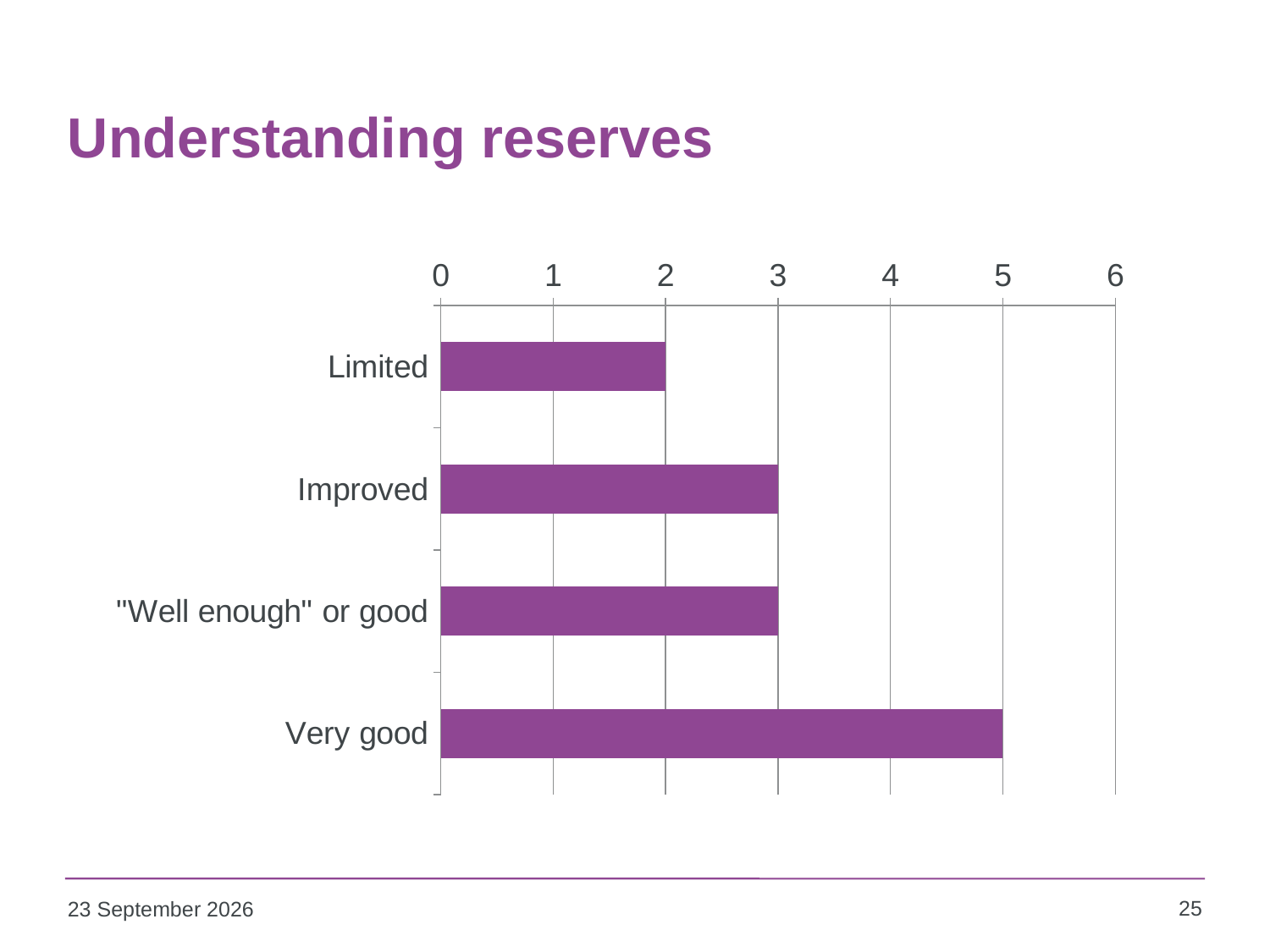
What is the title of the slide containing the chart? Understanding reserves What is the value for Limited? 2 What is the value for "Well enough" or good? 3 Is the value for Very good greater or less than 4? greater What is the value for Very good? 5 What is the difference between the values for Very good and Limited? 3 What kind of chart is shown on the slide? bar chart How many categories are plotted in the chart? 4 Which category has the lowest value? Limited Which category has the highest value? Very good Which is larger, the value for Improved or the value for Limited? Improved What is the value for Improved? 3